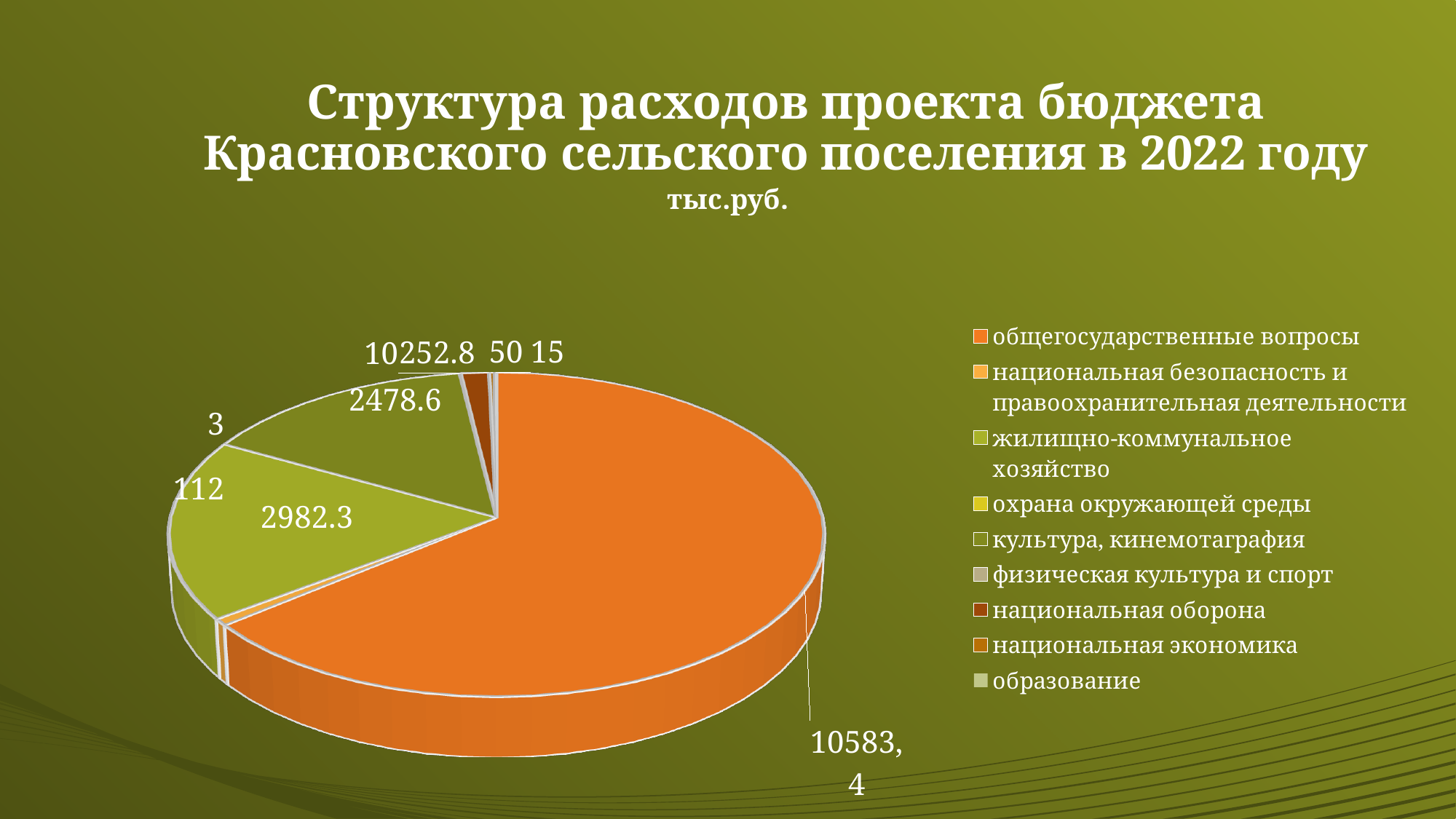
What is the value shown for культура, кинемотаграфия? 2478.6 In what units are the values of the chart given, according to the subtitle? тыс.руб. What is the value shown for охрана окружающей среды? 3 What is the value shown for национальная безопасность и правоохранительная деятельности? 112 What is the value shown for общегосударственные вопросы? 10583,4 What is the difference between the values for жилищно-коммунальное хозяйство and культура, кинемотаграфия? 503.7 What kind of chart is shown on the slide? pie chart Which category has the largest slice of the pie chart? общегосударственные вопросы What is the value shown for жилищно-коммунальное хозяйство? 2982.3 Which is larger: жилищно-коммунальное хозяйство or культура, кинемотаграфия? жилищно-коммунальное хозяйство What year does the chart title refer to? 2022 How many categories does the legend of the pie chart list? 9